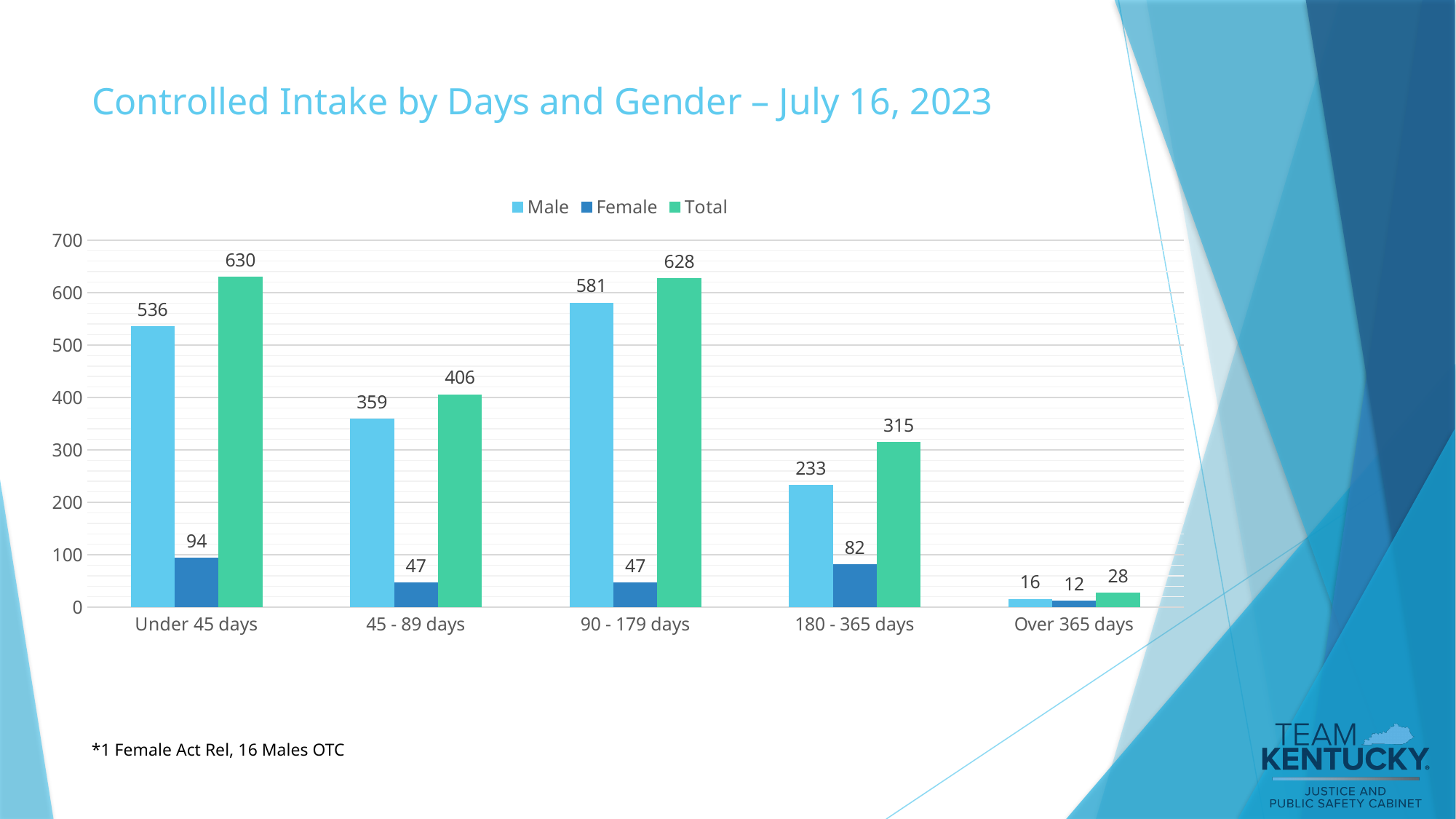
What is the Female value for the Under 45 days category? 94 How many series does the legend list? 3 What is the Male value for the 90 - 179 days category? 581 Which is larger, the Male value for Under 45 days or the Male value for 90 - 179 days? 90 - 179 days Which category has the highest Total value? Under 45 days What is the Total value for the 180 - 365 days category? 315 Which category has the lowest Male value? Over 365 days What is the title of the chart on the slide? Controlled Intake by Days and Gender – July 16, 2023 What is the difference between the Male and Female values for the 45 - 89 days category? 312 What kind of chart is shown on the slide? Bar chart How many day-range categories are shown on the x axis? 5 What is the Female value for the Over 365 days category? 12